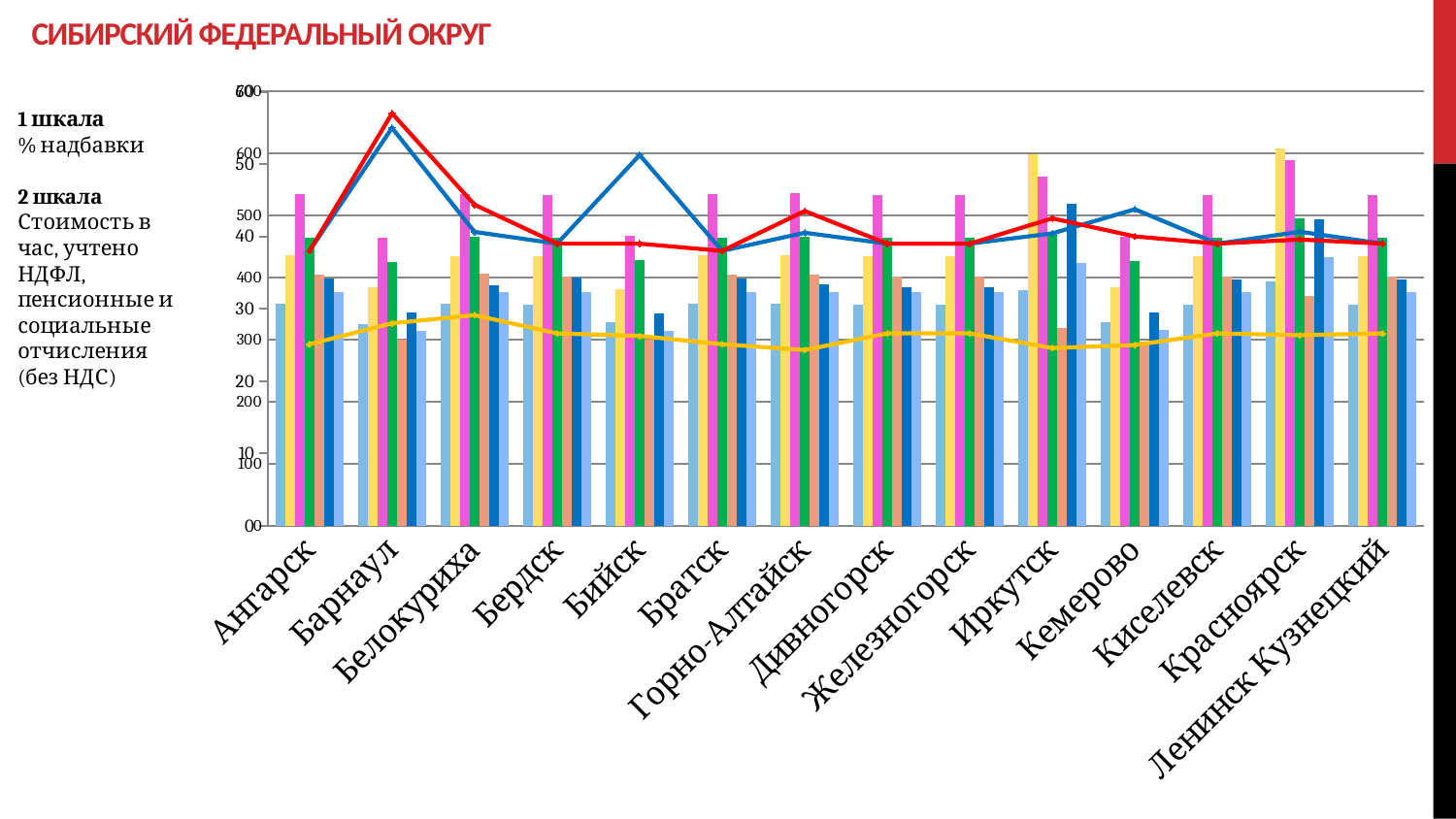
Which is the last category on the x axis of the chart? Ленинск Кузнецкий What kind of chart is shown on the slide? bar chart combined with line series At which category does the red line reach its highest point? Барнаул How many line series are plotted over the bars in the chart? 3 Which is the first category on the x axis of the chart? Ангарск Is the blue line higher at Барнаул or at Бийск? Барнаул What is the title of the slide containing the chart? СИБИРСКИЙ ФЕДЕРАЛЬНЫЙ ОКРУГ How many categories (cities) are shown along the x axis of the chart? 14 Is the red line higher at Барнаул or at Ангарск? Барнаул Which category comes immediately after Иркутск on the x axis? Кемерово